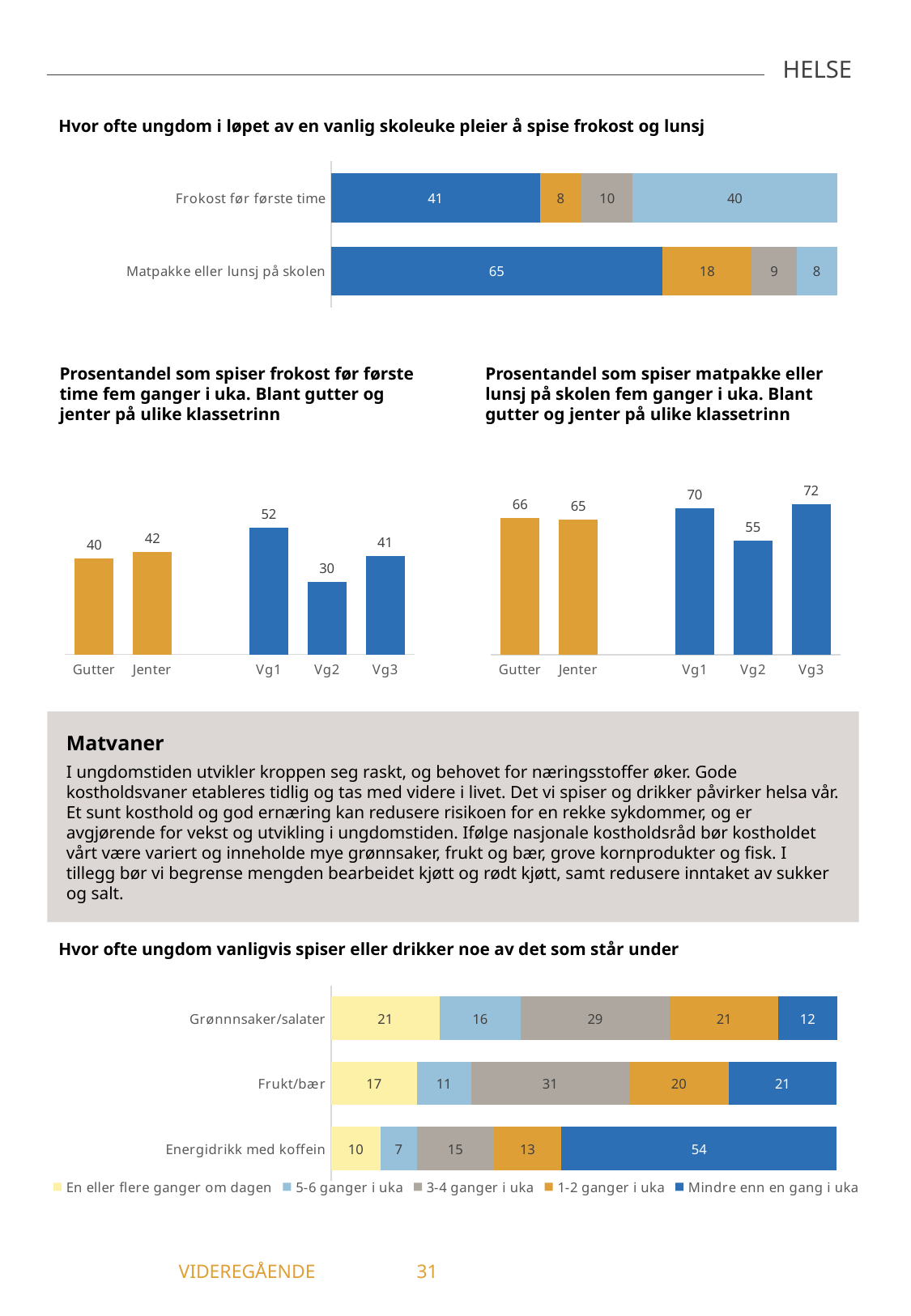
In the chart 'Prosentandel som spiser frokost før første time fem ganger i uka', which category has the highest value? Vg1 What kind of chart is 'Hvor ofte ungdom vanligvis spiser eller drikker noe av det som står under'? Stacked bar chart In the chart 'Hvor ofte ungdom vanligvis spiser eller drikker noe av det som står under', how many series does the legend list? 5 In the chart 'Hvor ofte ungdom i løpet av en vanlig skoleuke pleier å spise frokost og lunsj', what is the value of the last (light blue) segment for 'Frokost før første time'? 40 In the chart 'Prosentandel som spiser matpakke eller lunsj på skolen fem ganger i uka', what is the value for Vg3? 72 In the chart 'Hvor ofte ungdom vanligvis spiser eller drikker noe av det som står under', what is the value of '3-4 ganger i uka' for 'Frukt/bær'? 31 In the chart 'Prosentandel som spiser frokost før første time fem ganger i uka', what is the value for Vg2? 30 In the chart 'Hvor ofte ungdom vanligvis spiser eller drikker noe av det som står under', what is the value of 'Mindre enn en gang i uka' for 'Energidrikk med koffein'? 54 In the chart 'Prosentandel som spiser matpakke eller lunsj på skolen fem ganger i uka', how many categories are shown? 5 In the chart 'Hvor ofte ungdom i løpet av en vanlig skoleuke pleier å spise frokost og lunsj', what is the value of the first (dark blue) segment for 'Matpakke eller lunsj på skolen'? 65 In the chart 'Prosentandel som spiser frokost før første time fem ganger i uka', what is the difference between Jenter and Gutter? 2 In the chart 'Prosentandel som spiser matpakke eller lunsj på skolen fem ganger i uka', which category has the lowest value? Vg2